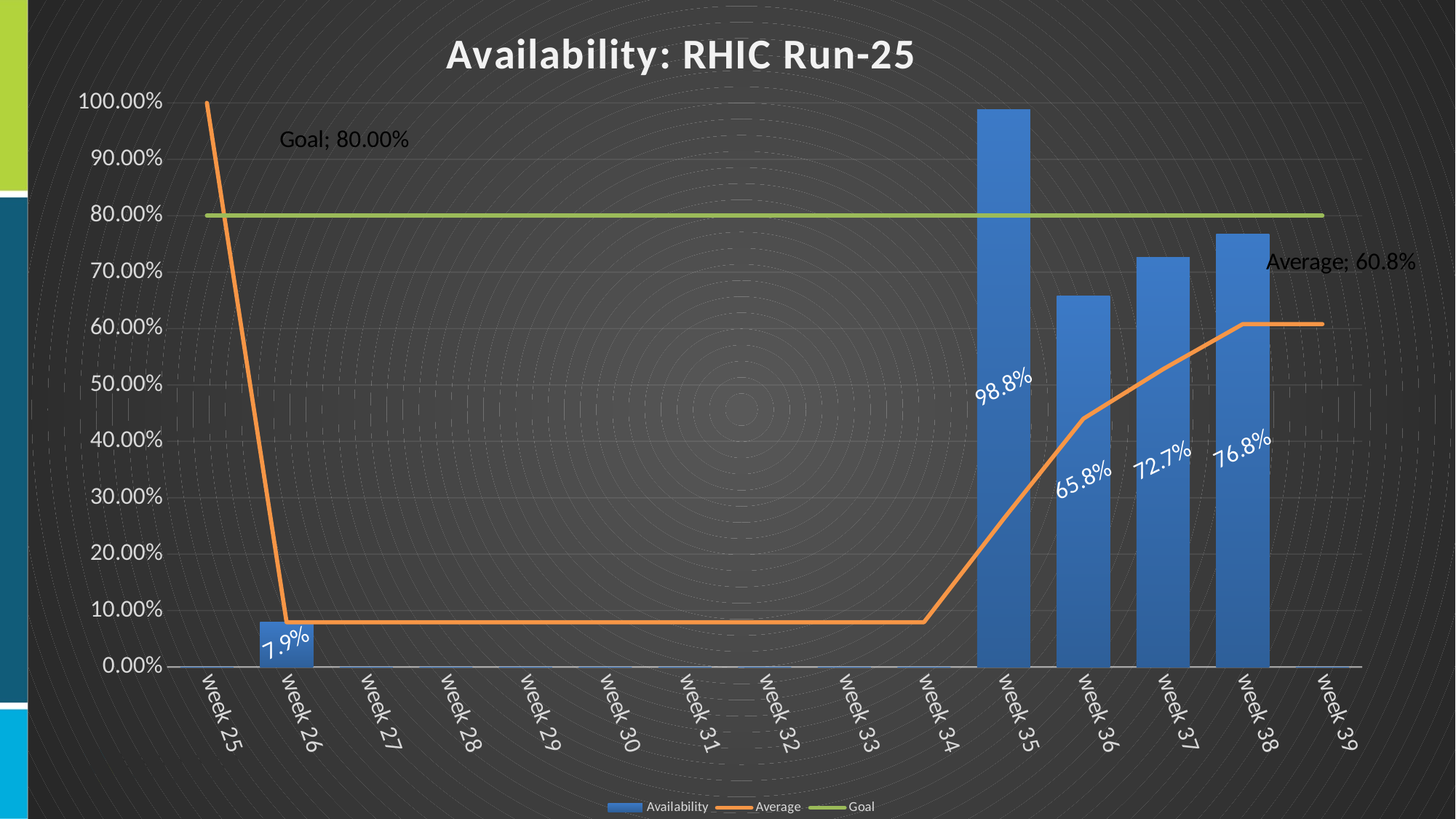
What is the Availability value for week 26? 7.9% What is the title of the chart? Availability: RHIC Run-25 What is the Availability value for week 35? 98.8% What is the Availability value for week 37? 72.7% What is the Availability value for week 38? 76.8% How many series does the legend list? 3 How many week categories are shown on the x axis? 15 Which is larger, the Availability for week 36 or week 37? week 37 What is the Average value labelled at the end of the Average line? 60.8% What is the Goal value shown on the chart? 80.00% What is the difference between the Availability for week 38 and week 36? 11.0% Which week has the highest Availability? week 35